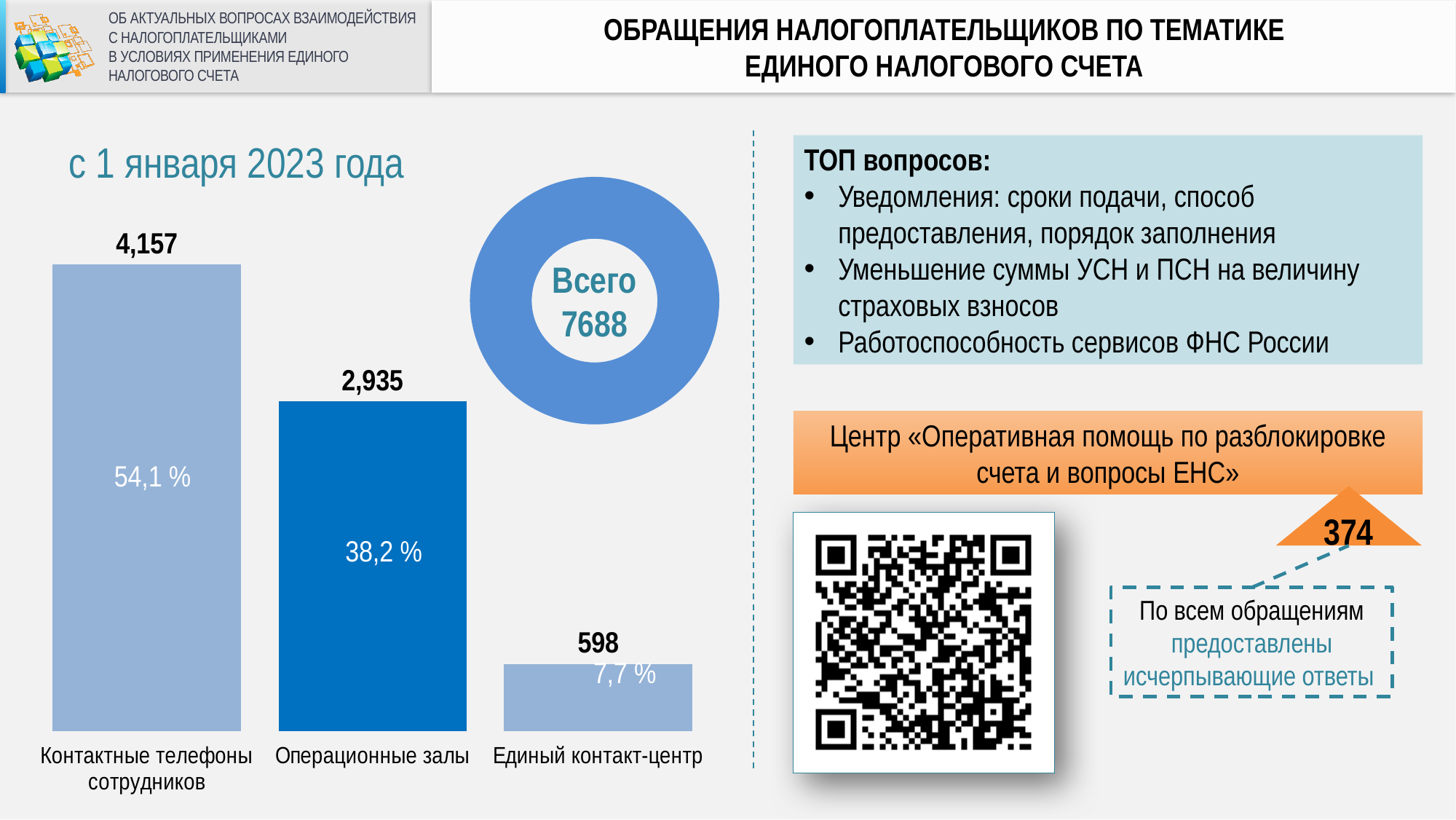
Which category has the highest value in the bar chart? Контактные телефоны сотрудников What value is shown for the bar labelled «Контактные телефоны сотрудников»? 4,157 What value is shown for the bar labelled «Операционные залы»? 2,935 What percentage is printed for «Контактные телефоны сотрудников»? 54,1 % What total («Всего») is shown in the circle next to the bar chart? 7688 What is the difference between the values for «Контактные телефоны сотрудников» and «Операционные залы»? 1,222 What percentage is printed inside the «Операционные залы» bar? 38,2 % Which is larger: the value for «Операционные залы» or for «Единый контакт-центр»? Операционные залы Which category has the lowest value in the bar chart? Единый контакт-центр How many categories does the bar chart show? 3 What is the difference between the values for «Операционные залы» and «Единый контакт-центр»? 2,337 What value is shown for the bar labelled «Единый контакт-центр»? 598